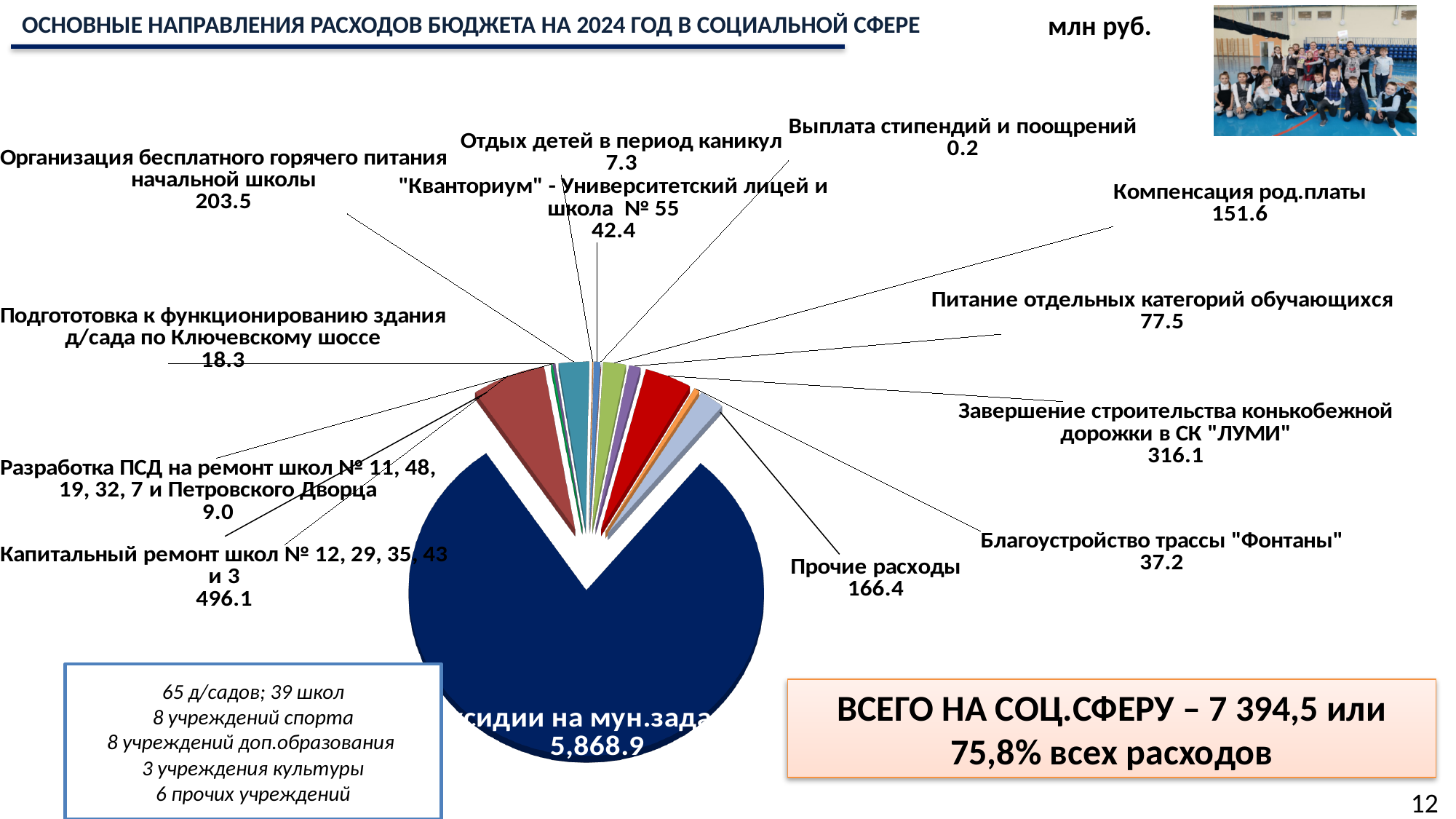
How many slices (categories) does the pie chart have? 13 What is the value for "Компенсация род.платы"? 151.6 In what units are the values on the chart given? млн руб. What is the value for "Прочие расходы"? 166.4 Which category has the smallest value in the pie chart? Выплата стипендий и поощрений What is the difference between "Организация бесплатного горячего питания начальной школы" and "Компенсация род.платы"? 51.9 What is the value of the largest slice of the pie chart? 5,868.9 Which is larger: "Прочие расходы" or "Питание отдельных категорий обучающихся"? Прочие расходы What is the difference between "Капитальный ремонт школ № 12, 29, 35, 43 и 3" and "Завершение строительства конькобежной дорожки в СК "ЛУМИ""? 180.0 What is the value for "Завершение строительства конькобежной дорожки в СК "ЛУМИ""? 316.1 What kind of chart is shown on the slide? Pie chart What is the value for "Капитальный ремонт школ № 12, 29, 35, 43 и 3"? 496.1